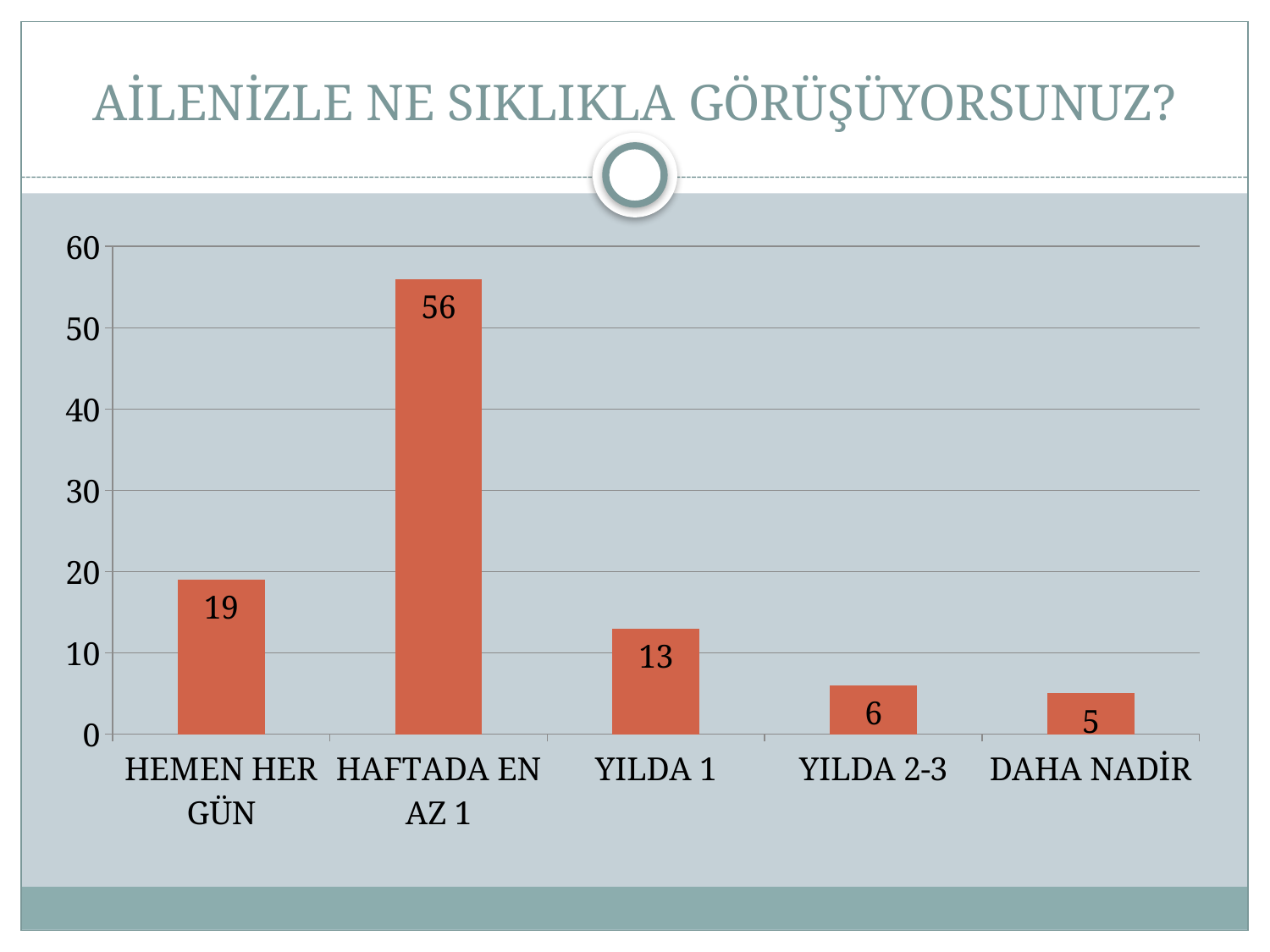
Which category has the highest value? HAFTADA EN AZ 1 What is the difference between the values for YILDA 1 and YILDA 2-3? 7 What is the value for HAFTADA EN AZ 1? 56 How many categories are shown on the x axis? 5 What is the value for YILDA 1? 13 Is the value for HAFTADA EN AZ 1 greater or less than 50? greater What is the value for HEMEN HER GÜN? 19 What is the difference between the values for HAFTADA EN AZ 1 and HEMEN HER GÜN? 37 What is the value for DAHA NADİR? 5 Which category has the lowest value? DAHA NADİR Which is larger, the value for HEMEN HER GÜN or the value for YILDA 1? HEMEN HER GÜN What kind of chart is shown on the slide? bar chart